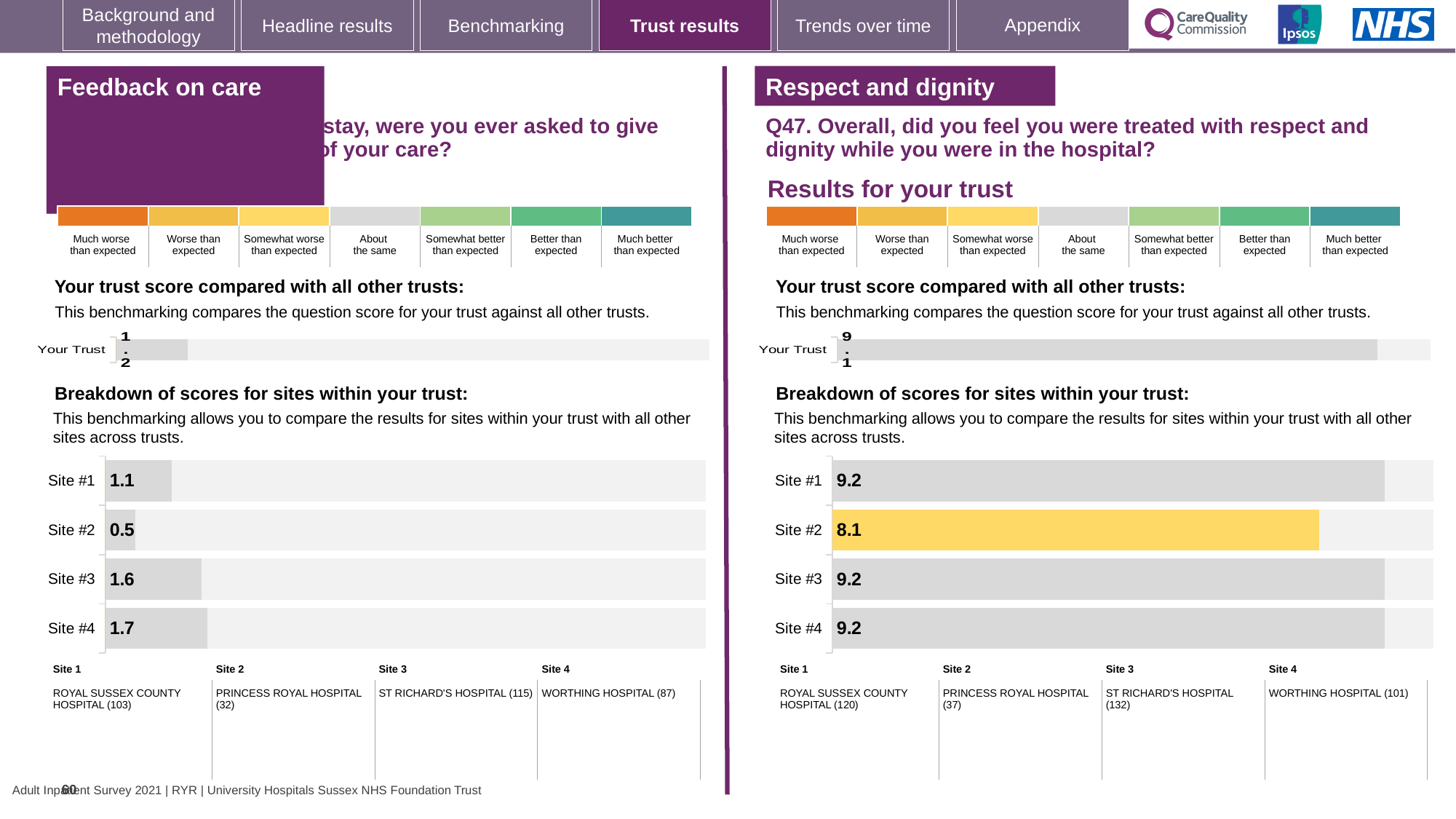
In the 'Feedback on care' site breakdown chart, which site has the lowest score? Site #2 In the 'Feedback on care' site breakdown chart, what is the difference between the scores for Site #4 and Site #1? 0.6 In the 'Feedback on care' site breakdown chart, which site has the highest score? Site #4 In the 'Respect and dignity' section, what is the 'Your Trust' score? 9.1 In the 'Feedback on care' section, what is the 'Your Trust' score? 1.2 In the 'Respect and dignity' site breakdown chart, what is the difference between the scores for Site #1 and Site #2? 1.1 How many sites are shown in the 'Feedback on care' site breakdown chart? 4 In the 'Respect and dignity' site breakdown chart, what is the score for Site #2? 8.1 In the 'Feedback on care' site breakdown chart, what is the score for Site #2? 0.5 In the 'Respect and dignity' site breakdown chart, which site has the lowest score? Site #2 In the 'Respect and dignity' site breakdown chart, is the score for Site #3 larger or smaller than the score for Site #2? larger What type of chart is used for the site breakdown in the 'Respect and dignity' section? bar chart